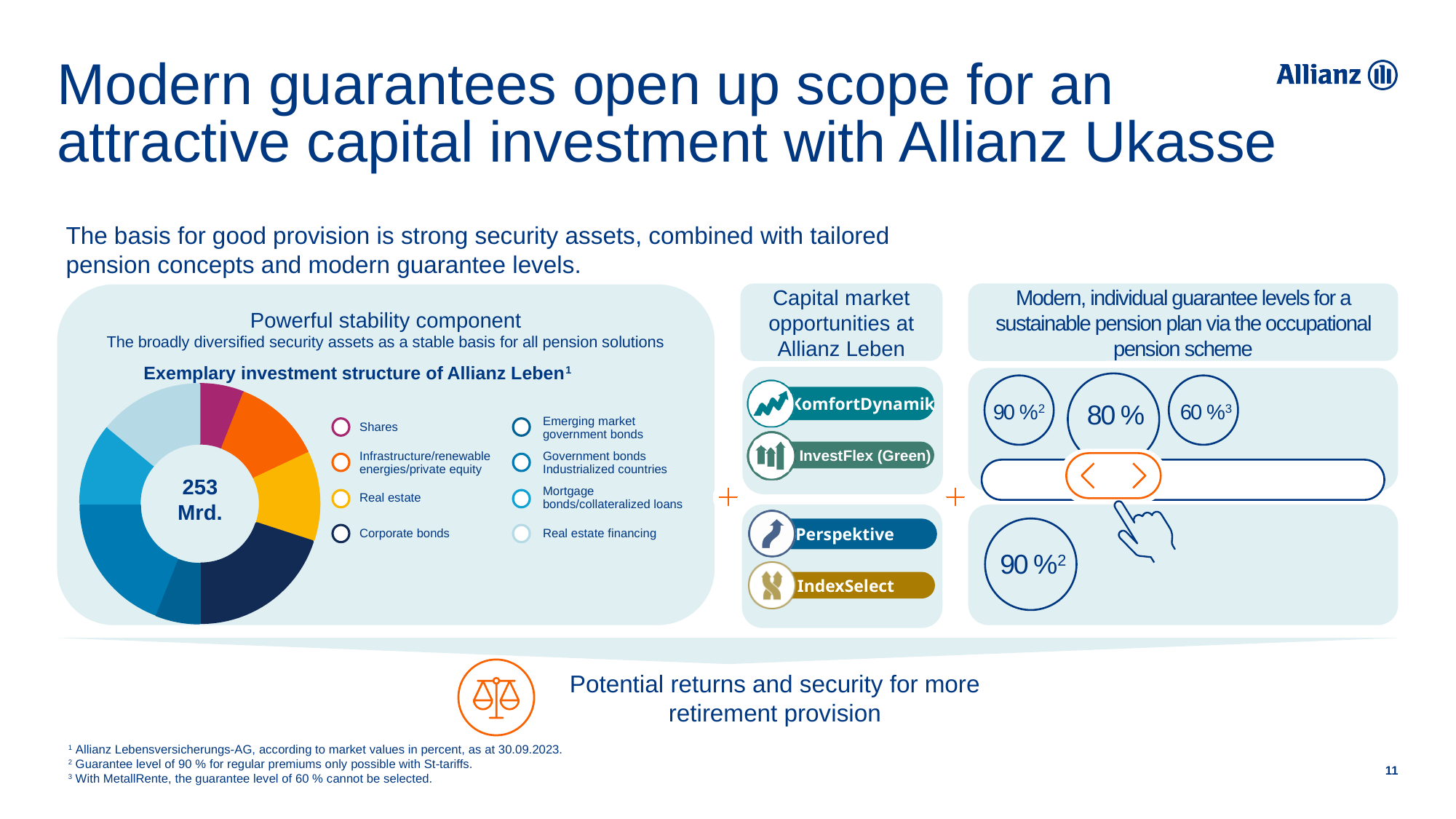
In the investment structure chart, which slice is larger: Infrastructure/renewable energies/private equity or Shares? Infrastructure/renewable energies/private equity What value is printed in the centre of the investment structure donut chart? 253 Mrd. What is the title of the donut chart on the left of the slide? Exemplary investment structure of Allianz Leben What kind of chart is used to show the exemplary investment structure of Allianz Leben? Pie chart (donut) In the investment structure chart, which slice is larger: Corporate bonds or Shares? Corporate bonds How many asset categories does the legend of the investment structure chart list? 8 In the investment structure chart, which slice is larger: Corporate bonds or Emerging market government bonds? Corporate bonds